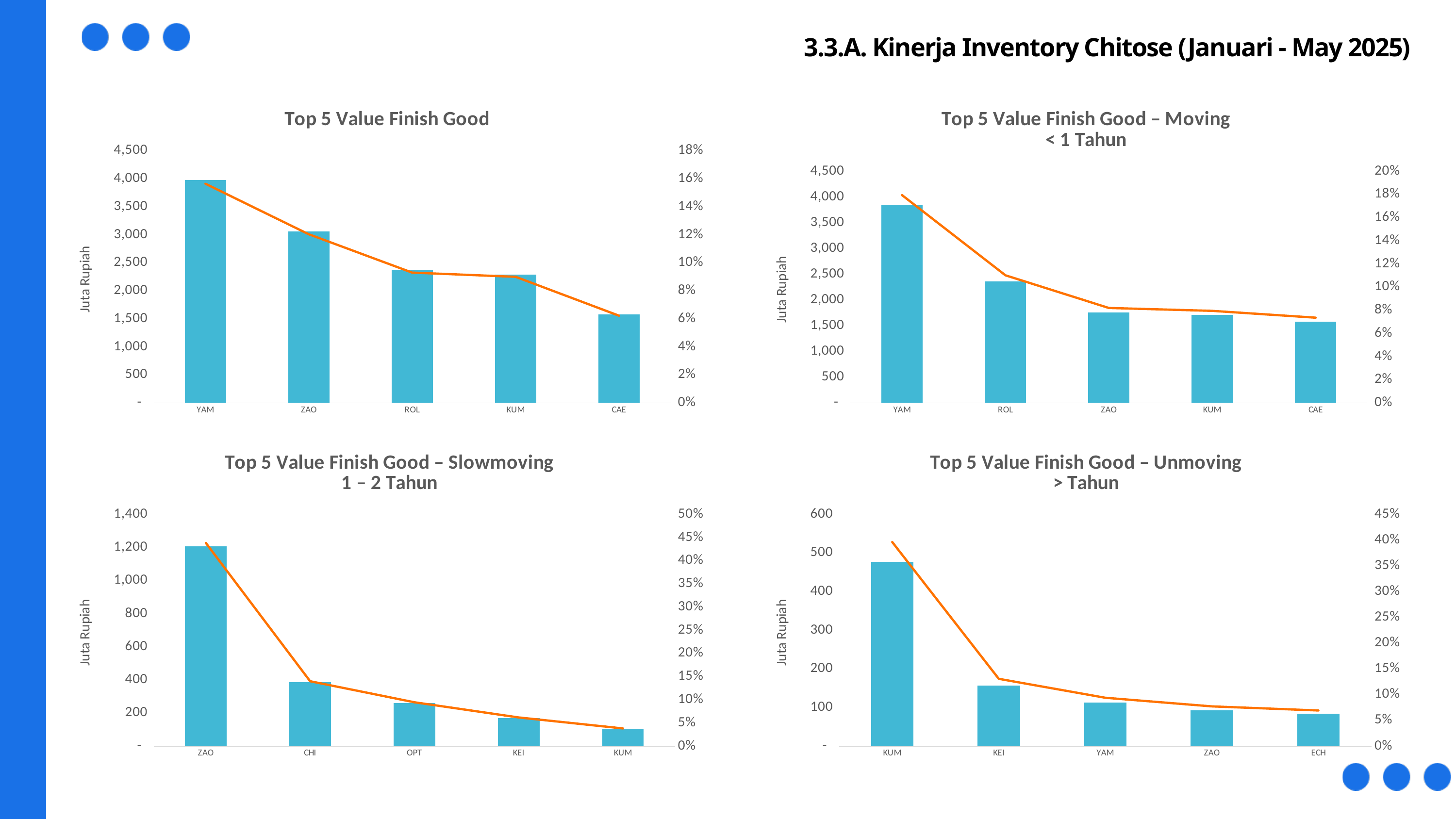
In the 'Top 5 Value Finish Good' chart, is the bar for YAM greater or less than 3,500? greater In the 'Top 5 Value Finish Good – Slowmoving 1 – 2 Tahun' chart, which category has the highest bar? ZAO In the 'Top 5 Value Finish Good – Moving < 1 Tahun' chart, which category has the highest bar? YAM In the 'Top 5 Value Finish Good' chart, which category has the shortest bar? CAE In the 'Top 5 Value Finish Good – Slowmoving 1 – 2 Tahun' chart, which category has the lowest bar? KUM How many categories are shown on the x axis of the 'Top 5 Value Finish Good – Unmoving > Tahun' chart? 5 In the 'Top 5 Value Finish Good – Moving < 1 Tahun' chart, is the bar for ROL greater or less than 2,000? greater In the 'Top 5 Value Finish Good – Unmoving > Tahun' chart, is the bar for KEI greater or less than 100? greater In the 'Top 5 Value Finish Good' chart, which category has the tallest bar? YAM